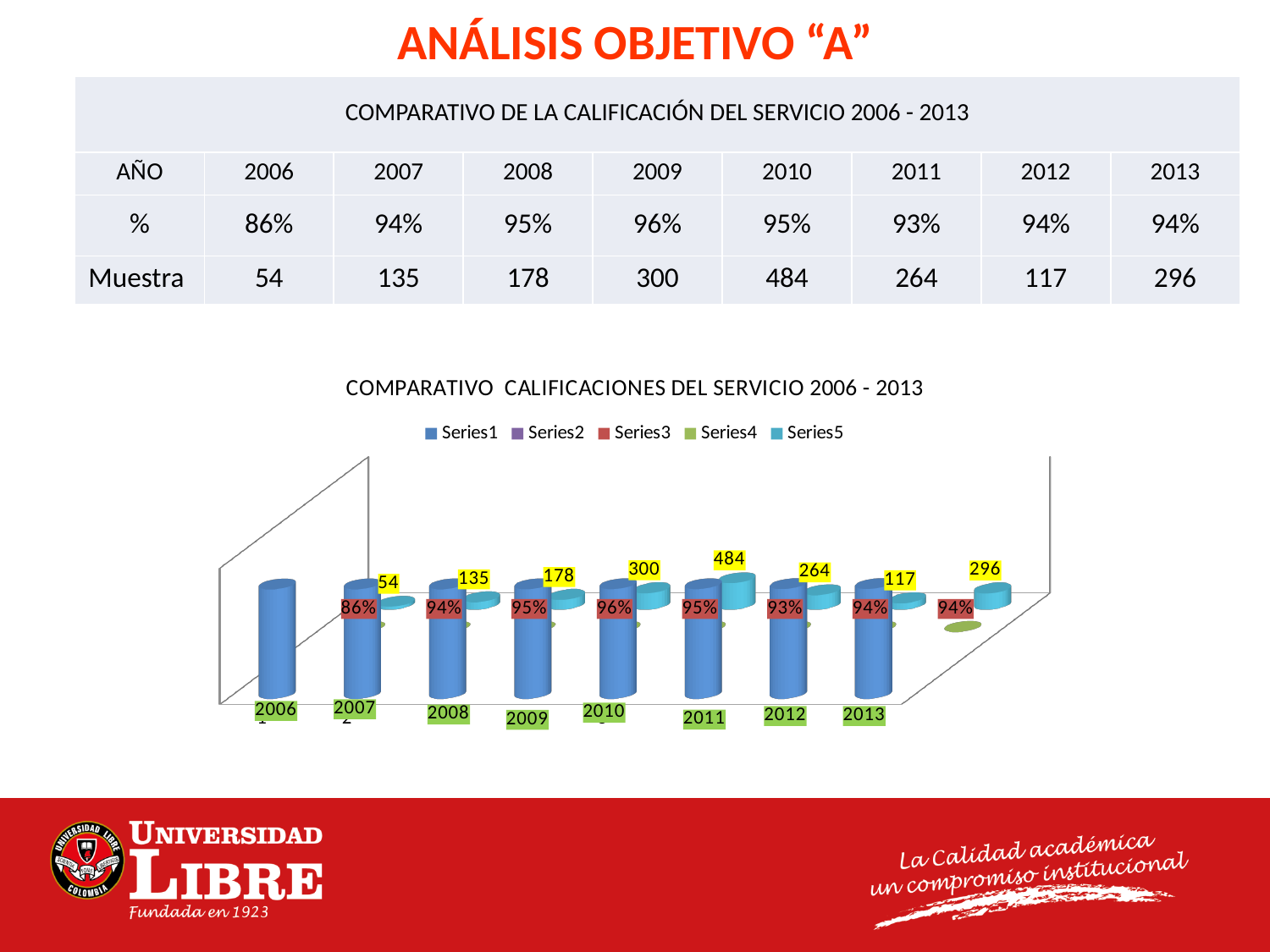
Which year has the largest sample size (Muestra) in the chart? 2010 What percentage is labelled for 2006 in the chart? 86% What sample size (Muestra) is labelled for 2013 in the chart? 296 How many years are shown along the x axis of the chart? 8 What is the title of the chart on the slide? COMPARATIVO CALIFICACIONES DEL SERVICIO 2006 - 2013 Which is larger in the chart, the sample size for 2008 or for 2012? 2008 Which year has the lowest percentage in the chart? 2006 Which year has the highest percentage in the chart? 2009 What sample size (Muestra) is labelled for 2010 in the chart? 484 What is the difference between the sample sizes for 2010 and 2011 in the chart? 220 What percentage is labelled for 2009 in the chart? 96% How many series does the chart legend list? 5